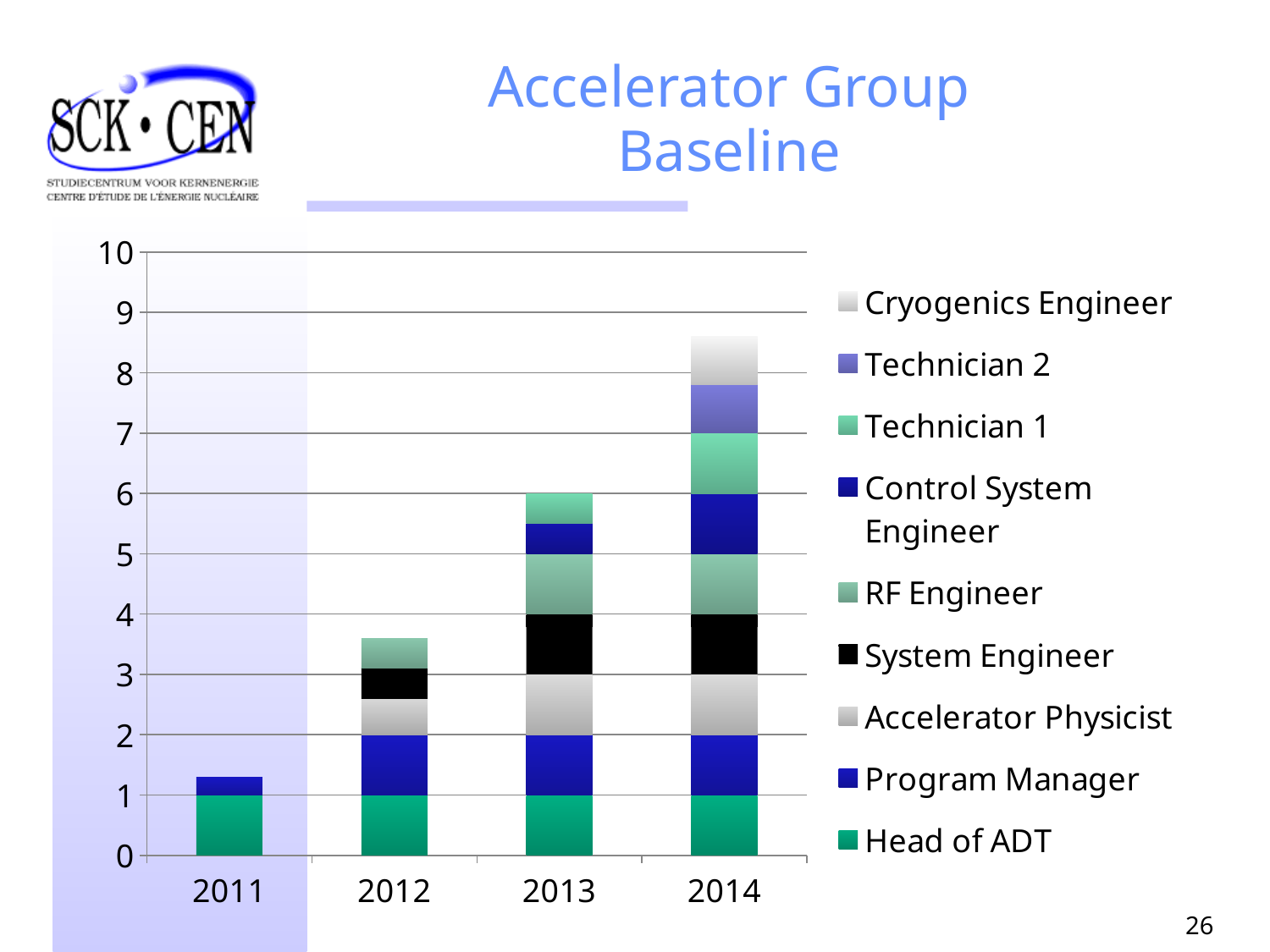
How many series does the chart's legend list? 9 What is the value of the Head of ADT segment in 2011? 1 How many years are shown on the x axis of the chart? 4 Which year has the tallest stacked bar? 2014 What kind of chart is shown on the slide? stacked bar chart Which year has the larger total, 2012 or 2013? 2013 Which year has the shortest stacked bar? 2011 Do the total bar heights rise or fall from 2011 to 2014? rise Is the total for 2011 greater or less than 2? less Is the total for 2014 greater or less than 8? greater Is the total for 2012 greater or less than 4? less Which series is shown in black in the legend? System Engineer